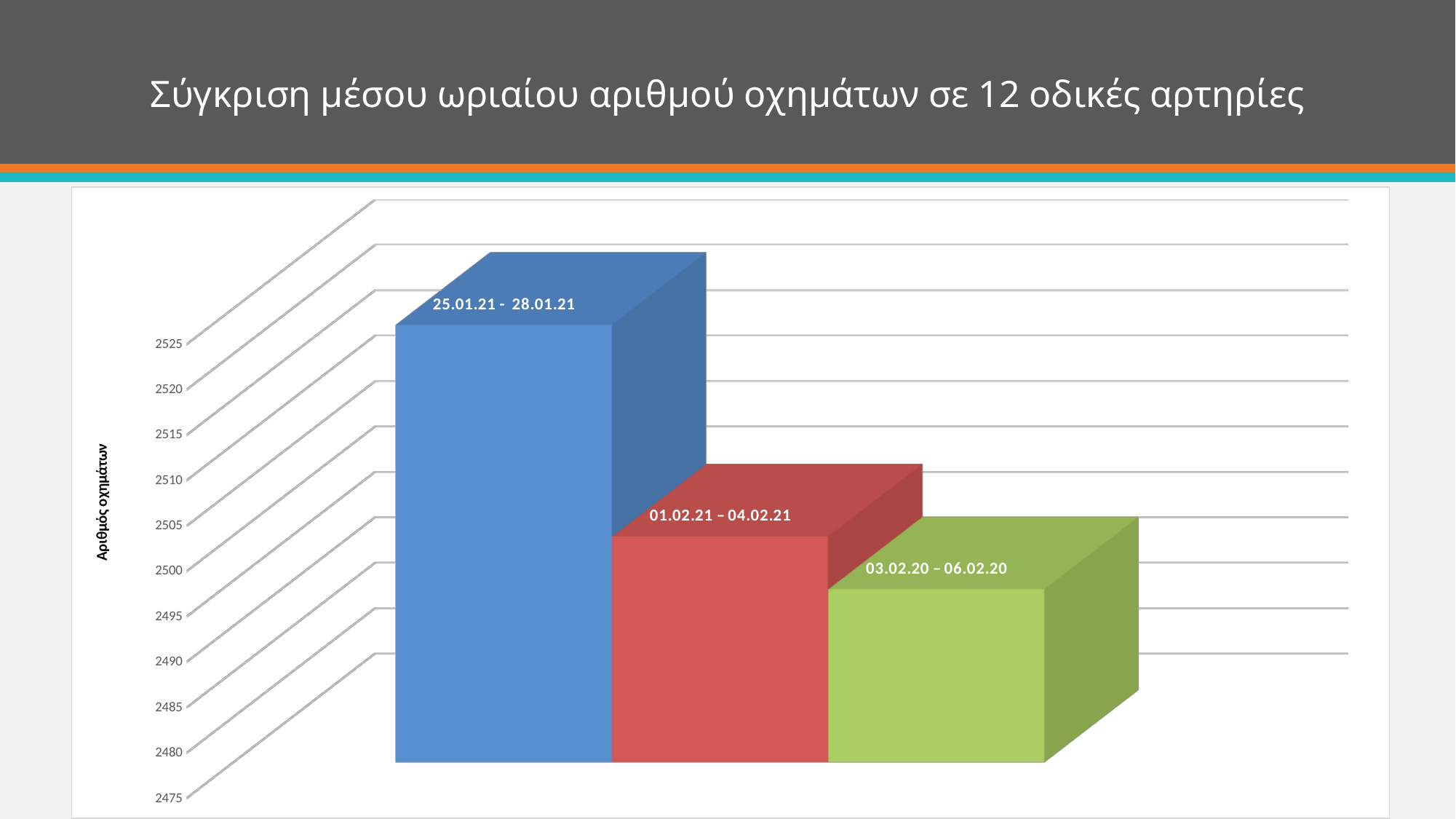
Which is larger, the value for 01.02.21 – 04.02.21 or the value for 03.02.20 – 06.02.20? 01.02.21 – 04.02.21 What kind of chart is shown on the slide? bar chart Is the value for 25.01.21 - 28.01.21 greater or less than 2510? greater Which period has the highest value in the chart? 25.01.21 - 28.01.21 Is the value for 01.02.21 – 04.02.21 greater or less than 2490? greater What colour is the bar for 03.02.20 – 06.02.20? green Which period has the lowest value in the chart? 03.02.20 – 06.02.20 Do the bar values rise or fall from left to right across the chart? fall Is the value for 03.02.20 – 06.02.20 greater or less than 2510? less What is the title of the vertical axis? Αριθμός οχημάτων Which is larger, the value for 25.01.21 - 28.01.21 or the value for 01.02.21 – 04.02.21? 25.01.21 - 28.01.21 How many bars are plotted in the chart? 3